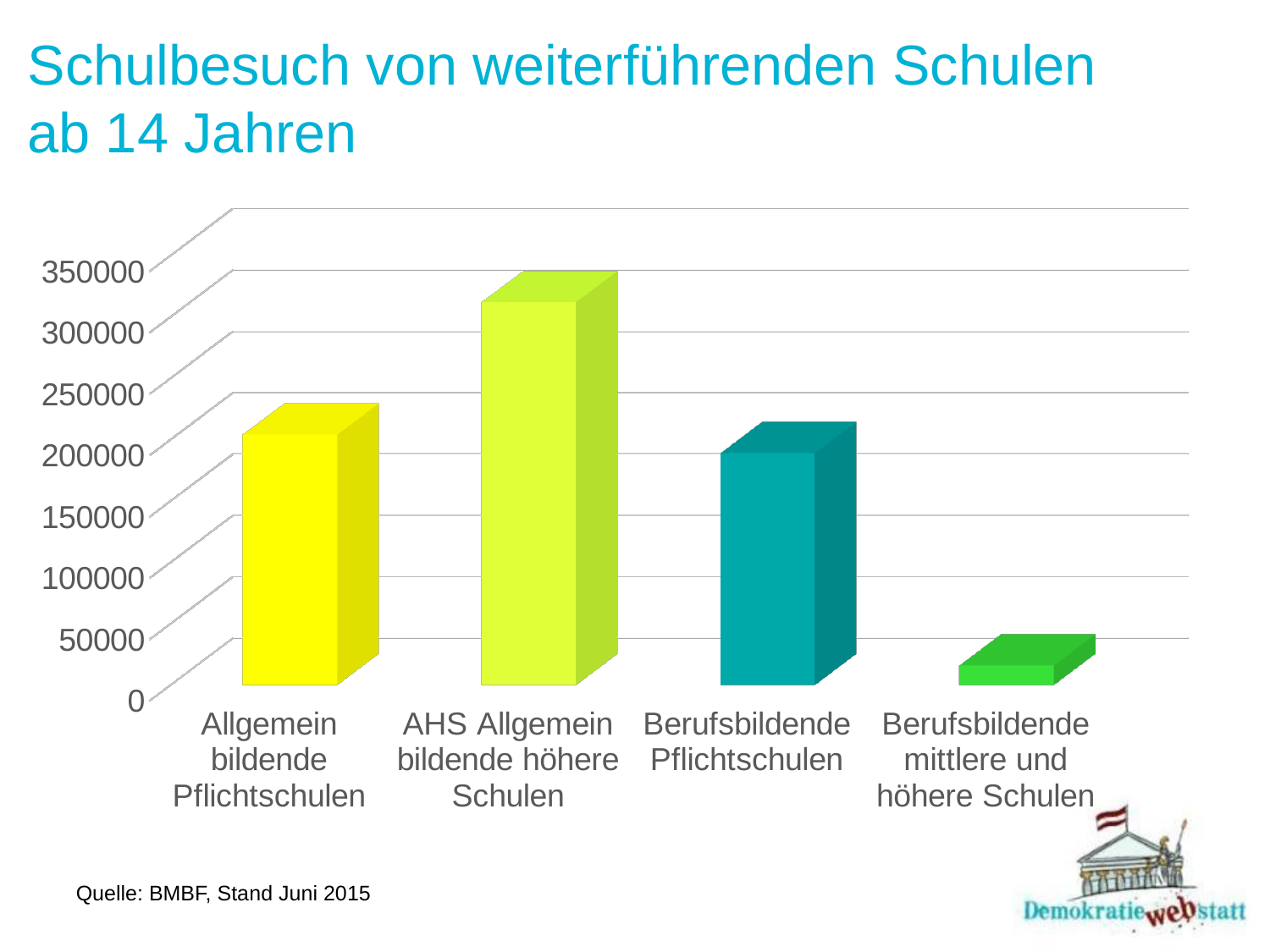
What is the title of the slide containing the chart? Schulbesuch von weiterführenden Schulen ab 14 Jahren How many categories are shown on the x axis of the chart? 4 Is the value for Allgemein bildende Pflichtschulen greater or less than 250000? less Is the value for AHS Allgemein bildende höhere Schulen greater or less than 300000? greater Which category has the highest value in the chart? AHS Allgemein bildende höhere Schulen Is the value for Berufsbildende Pflichtschulen greater or less than 150000? greater What kind of chart is shown on the slide? Bar chart Which is larger: the value for AHS Allgemein bildende höhere Schulen or the value for Berufsbildende Pflichtschulen? AHS Allgemein bildende höhere Schulen What source is given for the chart data? BMBF, Stand Juni 2015 Which category has the lowest value in the chart? Berufsbildende mittlere und höhere Schulen